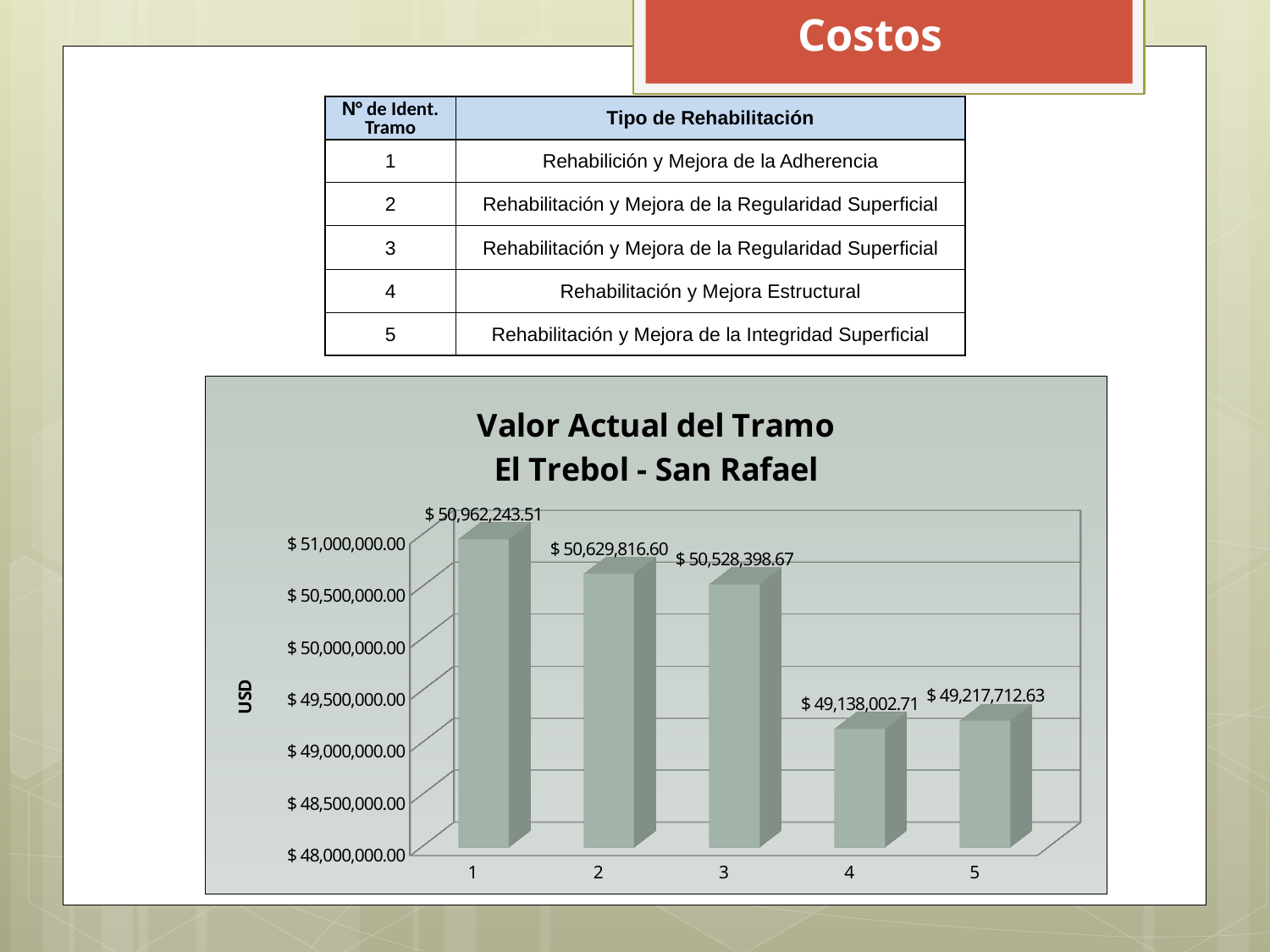
Which tramo has the highest value in the chart? 1 How many tramos are plotted in the chart? 5 What is the value for tramo 1 in the chart? $ 50,962,243.51 What is the label of the vertical axis of the chart? USD What is the difference between the values for tramo 5 and tramo 4? $ 79,709.92 What kind of chart is shown on the slide? bar chart Which has a larger value, tramo 2 or tramo 3? tramo 2 What is the value for tramo 5 in the chart? $ 49,217,712.63 What is the difference between the values for tramo 1 and tramo 2? $ 332,426.91 Is the value for tramo 3 greater or less than $ 50,000,000.00? greater What is the value for tramo 4 in the chart? $ 49,138,002.71 Which tramo has the lowest value in the chart? 4